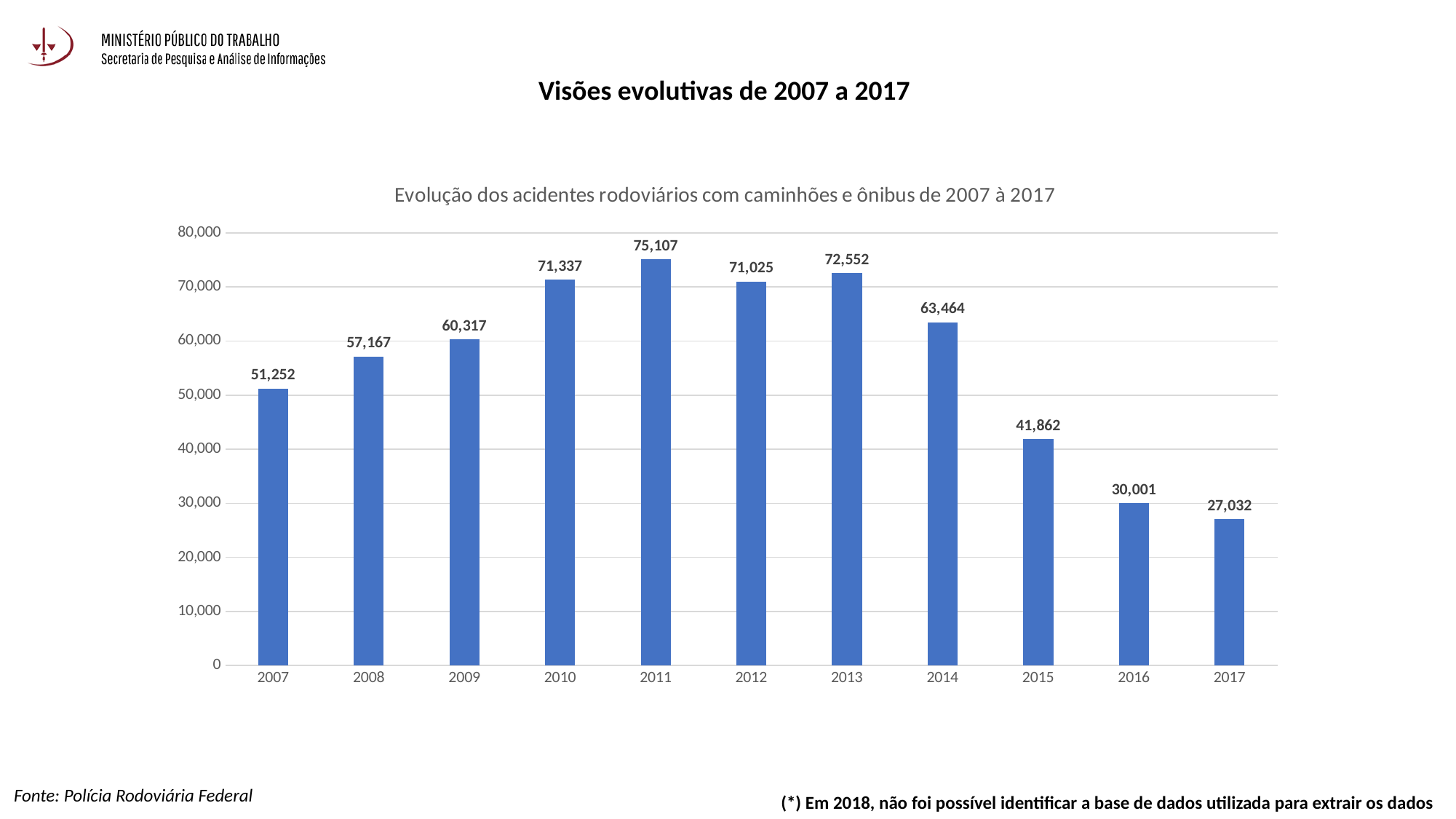
What is the difference between the values for 2011 and 2017? 48,075 Do the values rise or fall from 2013 to 2017? Fall What is the value for 2014? 63,464 Is the value for 2013 greater or less than 70,000? greater What is the value for 2017? 27,032 What is the value for 2007? 51,252 What kind of chart is shown on the slide? Bar chart Which year has the lowest value? 2017 What is the difference between the values for 2015 and 2016? 11,861 Which is larger, the value for 2010 or the value for 2012? 2010 Which year has the highest value? 2011 How many years are shown on the x axis? 11